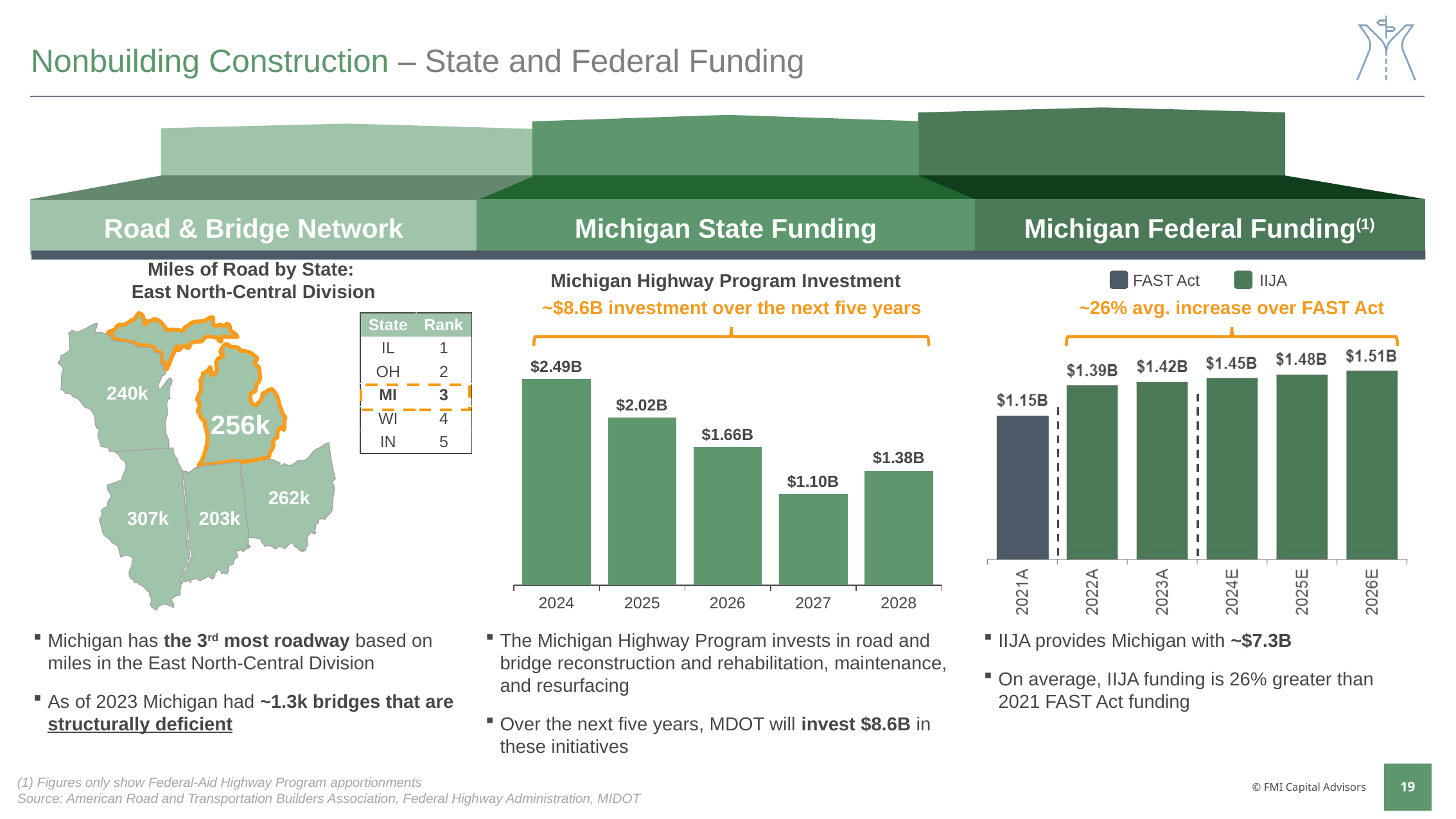
In the Michigan Federal Funding chart, what is the value for 2026E? $1.51B In the Michigan Highway Program Investment chart, what is the value for 2024? $2.49B In the Michigan Highway Program Investment chart, which year has the highest value? 2024 In the Michigan Federal Funding chart, what is the value for 2021A? $1.15B How many series does the legend of the Michigan Federal Funding chart list? 2 What kind of chart is the Michigan Highway Program Investment chart? Bar chart In the Michigan Federal Funding chart, do the values rise or fall from 2021A to 2026E? Rise In the Michigan Federal Funding chart, which year has the lowest value? 2021A In the Michigan Highway Program Investment chart, what is the difference between the 2024 and 2025 values? $0.47B In the Michigan Highway Program Investment chart, which year has the lowest value? 2027 In the Michigan Highway Program Investment chart, what is the value for 2027? $1.10B In the Michigan Highway Program Investment chart, how many years are plotted? 5